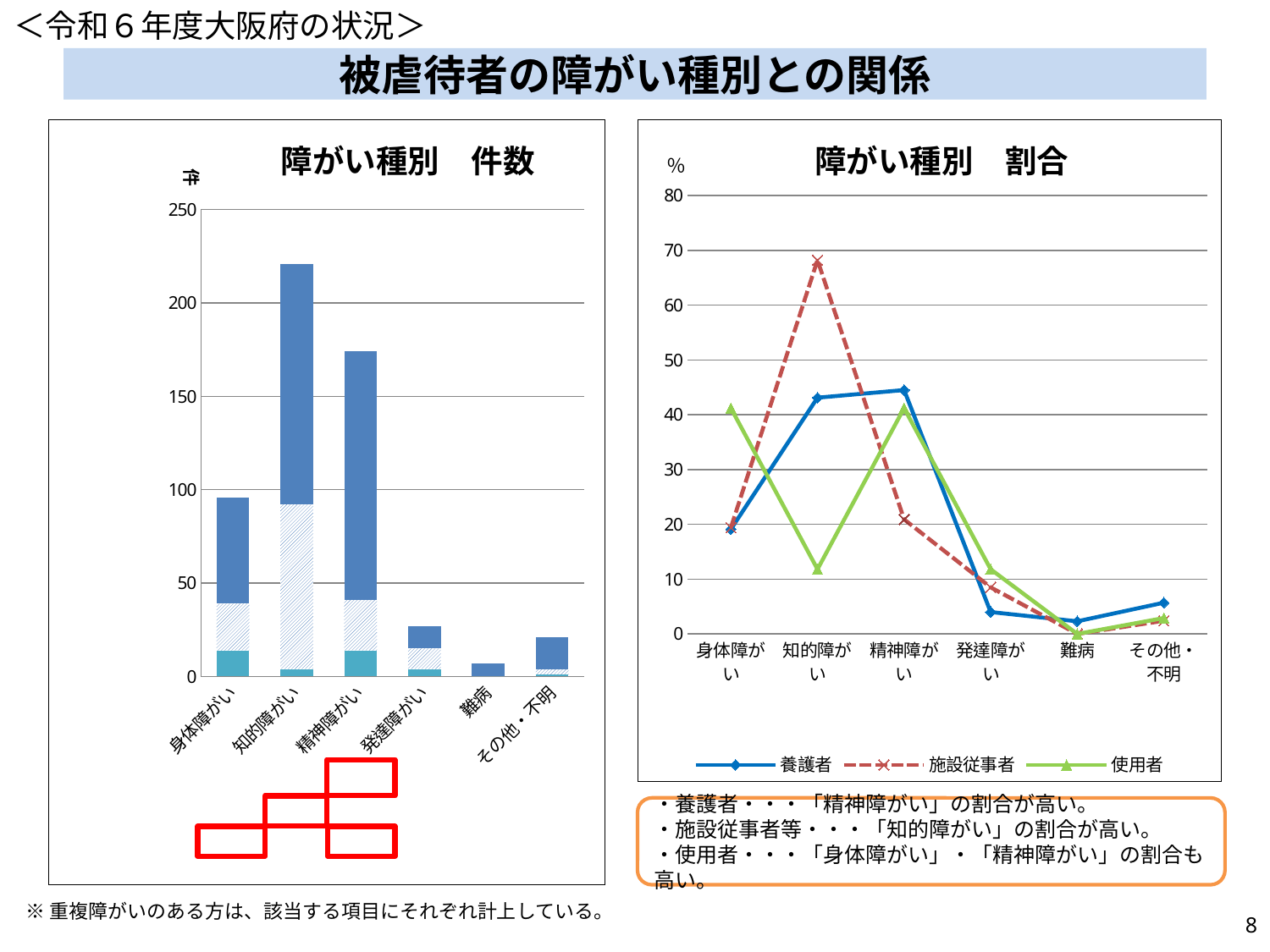
In the chart titled 障がい種別 割合, at 知的障がい, which series has the larger value: 施設従事者 or 養護者? 施設従事者 In the chart titled 障がい種別 件数, is the total value for 知的障がい greater or less than 200? greater In the chart titled 障がい種別 割合, is the value of 施設従事者 for 知的障がい greater or less than 60? greater In the chart titled 障がい種別 割合, at which category does the 施設従事者 series reach its highest value? 知的障がい How many series does the legend of the chart titled 障がい種別 割合 list? 3 In the chart titled 障がい種別 件数, is the total value for 精神障がい greater or less than 150? greater In the chart titled 障がい種別 件数, which category has the shortest bar? 難病 In the chart titled 障がい種別 件数, how many categories are shown on the x axis? 6 In the chart titled 障がい種別 件数, which category has the tallest bar? 知的障がい What kind of chart is the chart titled 障がい種別 割合? line chart What kind of chart is the chart titled 障がい種別 件数? bar chart